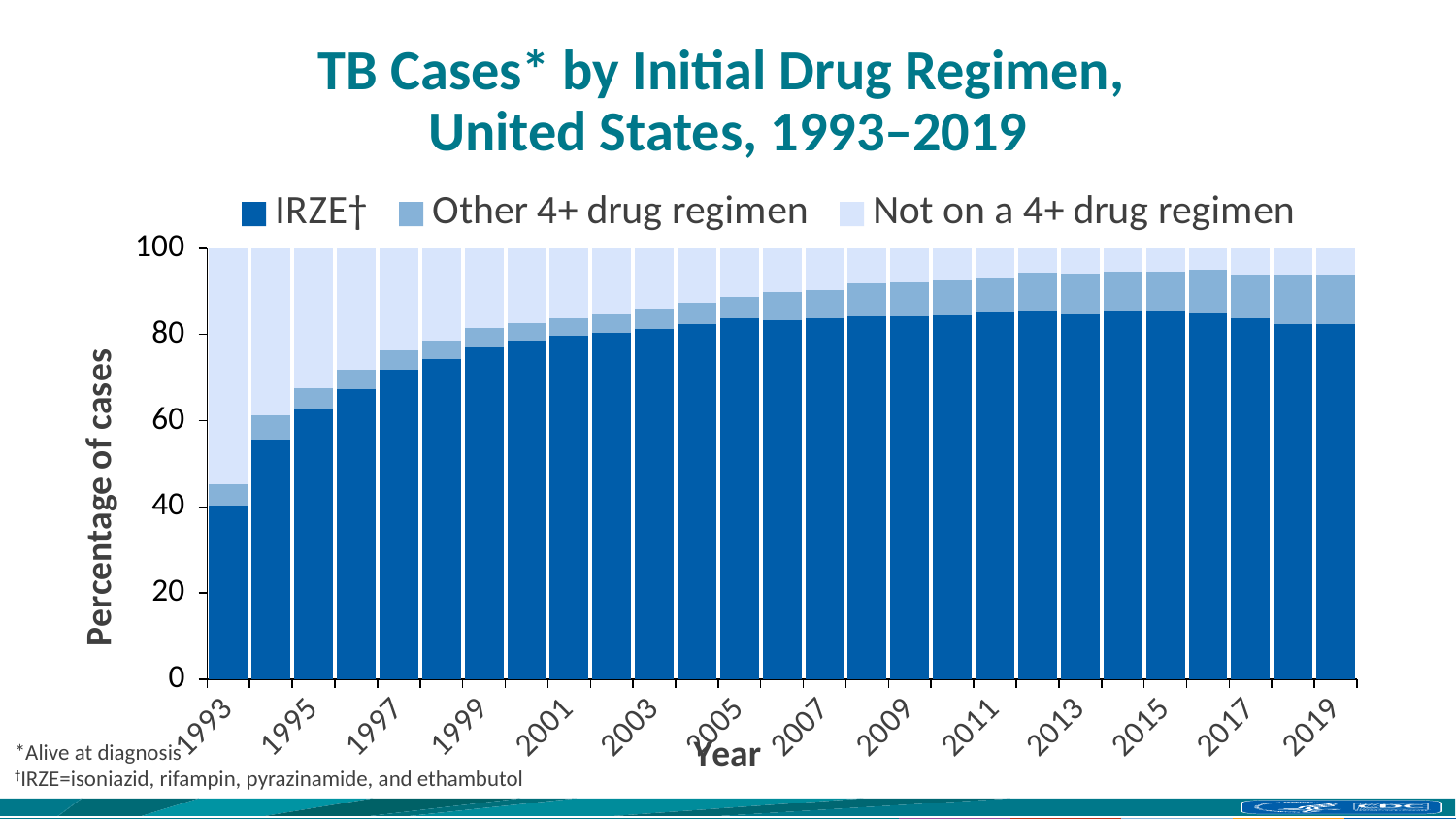
Which year has the lowest IRZE percentage? 1993 What is the title of the chart? TB Cases* by Initial Drug Regimen, United States, 1993–2019 How many series does the legend list? 3 Is the IRZE value for 2019 greater or less than 80? greater What is the label of the y axis? Percentage of cases What kind of chart is shown on the slide? Stacked bar chart Which year has the larger IRZE percentage, 1993 or 2019? 2019 Does the IRZE percentage generally rise or fall from 1993 to 2019? rise What is the total height of each stacked bar on the y axis? 100 Is the IRZE value for 1993 greater or less than 60? less How many years (bars) are plotted on the chart? 27 Is the IRZE value for 1997 greater or less than 60? greater